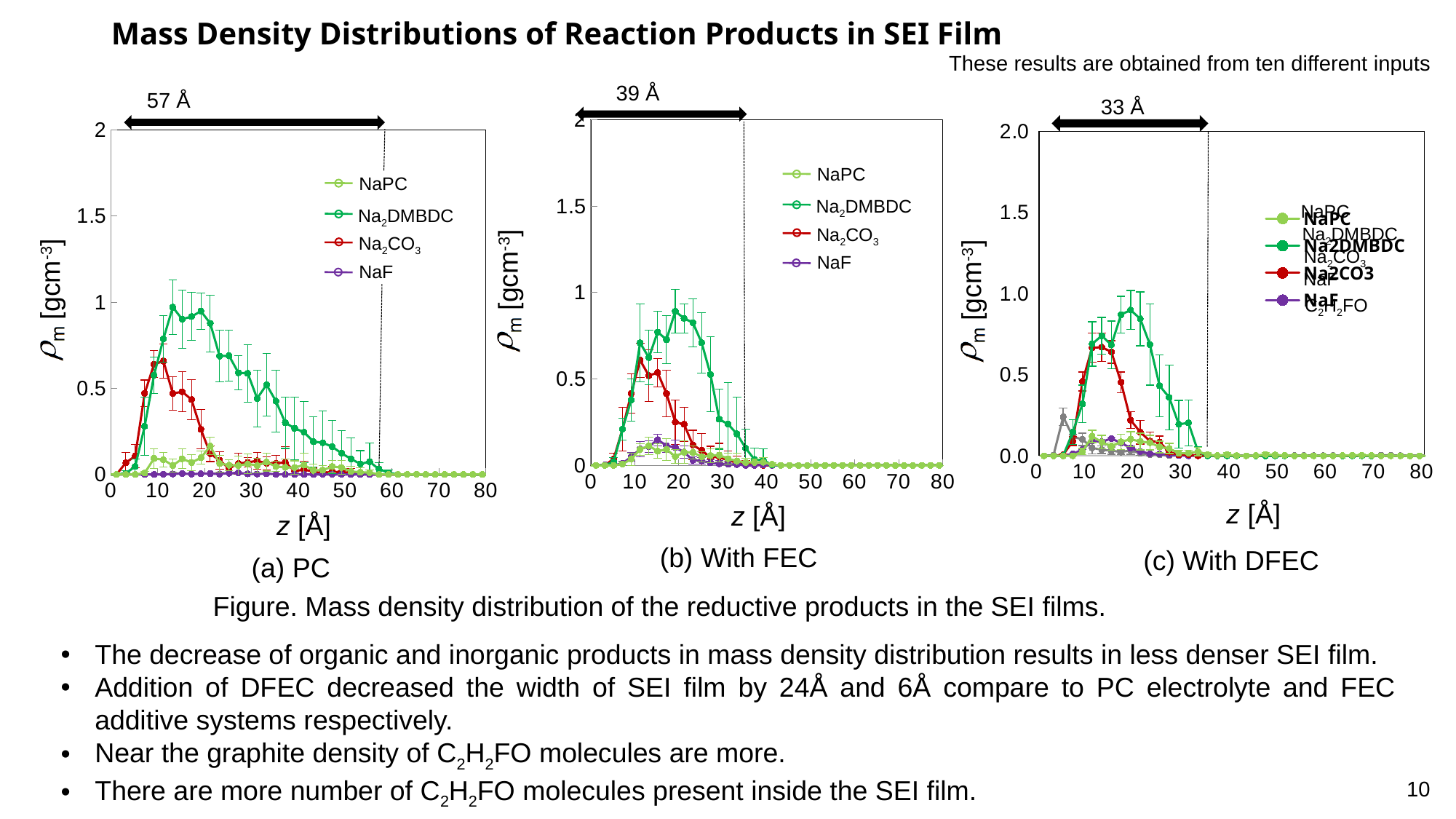
What kind of chart is chart (a) PC? line chart In chart (c) With DFEC, is the peak value of Na2DMBDC greater or less than 0.5? greater In chart (a) PC, does the Na2DMBDC curve rise or fall as z increases from 20 Å to 60 Å? fall What SEI film width is annotated above chart (c) With DFEC? 33 Å What SEI film width is annotated above chart (a) PC? 57 Å In chart (b) With FEC, is the peak value of NaF greater or less than 0.5? less In chart (b) With FEC, how many series does the legend list? 4 In chart (a) PC, is the peak value of Na2CO3 greater or less than 1? less In chart (b) With FEC, which series reaches the highest mass density? Na2DMBDC In chart (a) PC, how many series does the legend list? 4 In chart (a) PC, which series reaches the highest mass density? Na2DMBDC